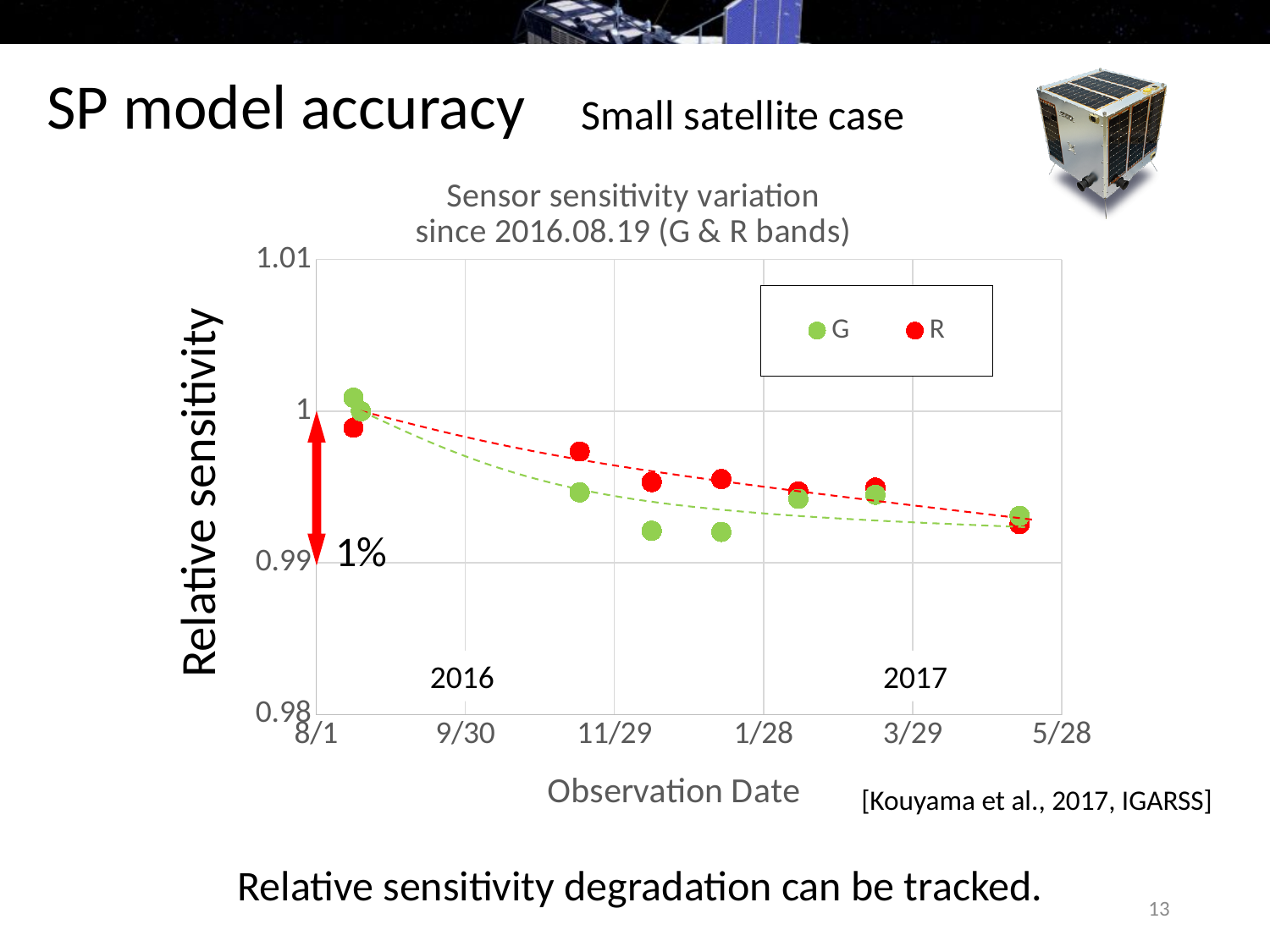
How many series does the chart legend list? 2 At the observation just before 11/29, which series has the higher value, G or R? R Are the G values plotted between 11/29 and 1/28 greater or less than 1? less Do the relative sensitivity values rise or fall as the observation date advances along the x axis? Fall What is the label of the x axis? Observation Date What are the two series named in the chart legend? G and R What is the title of the chart? Sensor sensitivity variation since 2016.08.19 (G & R bands) At the first observation near 8/1, which series has the higher value, G or R? G Is the last R value (near 5/28) greater or less than 0.98? greater What kind of chart is shown on the slide? Scatter chart Is the first G value (near 8/1) greater or less than 0.99? greater